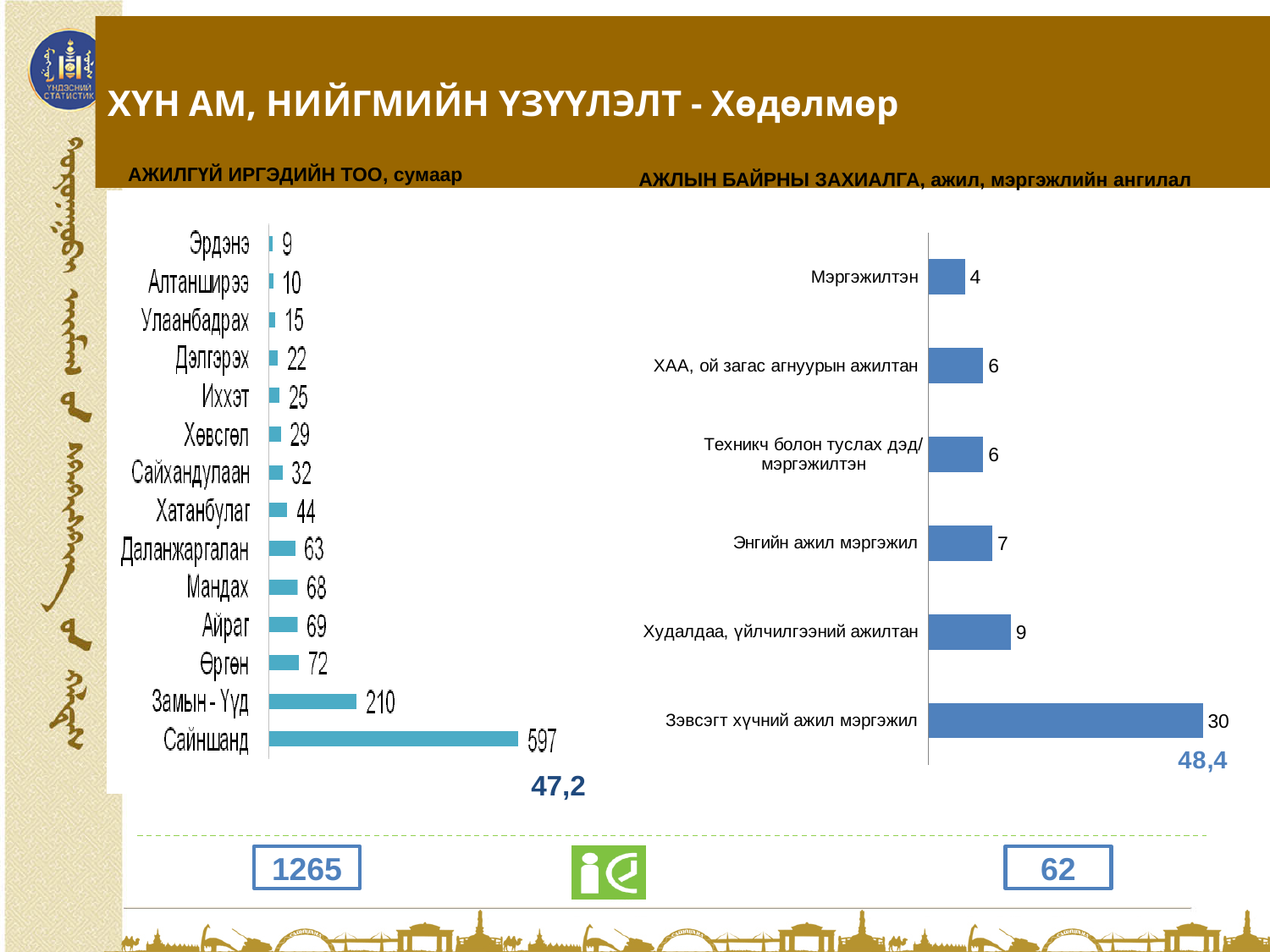
In the chart titled "АЖИЛГҮЙ ИРГЭДИЙН ТОО, сумаар", what is the value for Замын-Үүд? 210 In the chart titled "АЖЛЫН БАЙРНЫ ЗАХИАЛГА, ажил, мэргэжлийн ангилал", how many categories are shown? 6 In the chart titled "АЖЛЫН БАЙРНЫ ЗАХИАЛГА, ажил, мэргэжлийн ангилал", which category has the lowest value? Мэргэжилтэн In the chart titled "АЖЛЫН БАЙРНЫ ЗАХИАЛГА, ажил, мэргэжлийн ангилал", what is the difference between Худалдаа, үйлчилгээний ажилтан and Энгийн ажил мэргэжил? 2 What type of chart is the chart titled "АЖЛЫН БАЙРНЫ ЗАХИАЛГА, ажил, мэргэжлийн ангилал"? Bar chart In the chart titled "АЖЛЫН БАЙРНЫ ЗАХИАЛГА, ажил, мэргэжлийн ангилал", what is the value for Зэвсэгт хүчний ажил мэргэжил? 30 In the chart titled "АЖЛЫН БАЙРНЫ ЗАХИАЛГА, ажил, мэргэжлийн ангилал", which category has the highest value? Зэвсэгт хүчний ажил мэргэжил In the chart titled "АЖИЛГҮЙ ИРГЭДИЙН ТОО, сумаар", what is the value for Сайншанд? 597 In the chart titled "АЖИЛГҮЙ ИРГЭДИЙН ТОО, сумаар", which category has the lowest value? Эрдэнэ In the chart titled "АЖИЛГҮЙ ИРГЭДИЙН ТОО, сумаар", which is larger, Мандах or Хатанбулаг? Мандах In the chart titled "АЖИЛГҮЙ ИРГЭДИЙН ТОО, сумаар", how many categories are shown? 14 In the chart titled "АЖИЛГҮЙ ИРГЭДИЙН ТОО, сумаар", what is the difference between Сайншанд and Замын-Үүд? 387